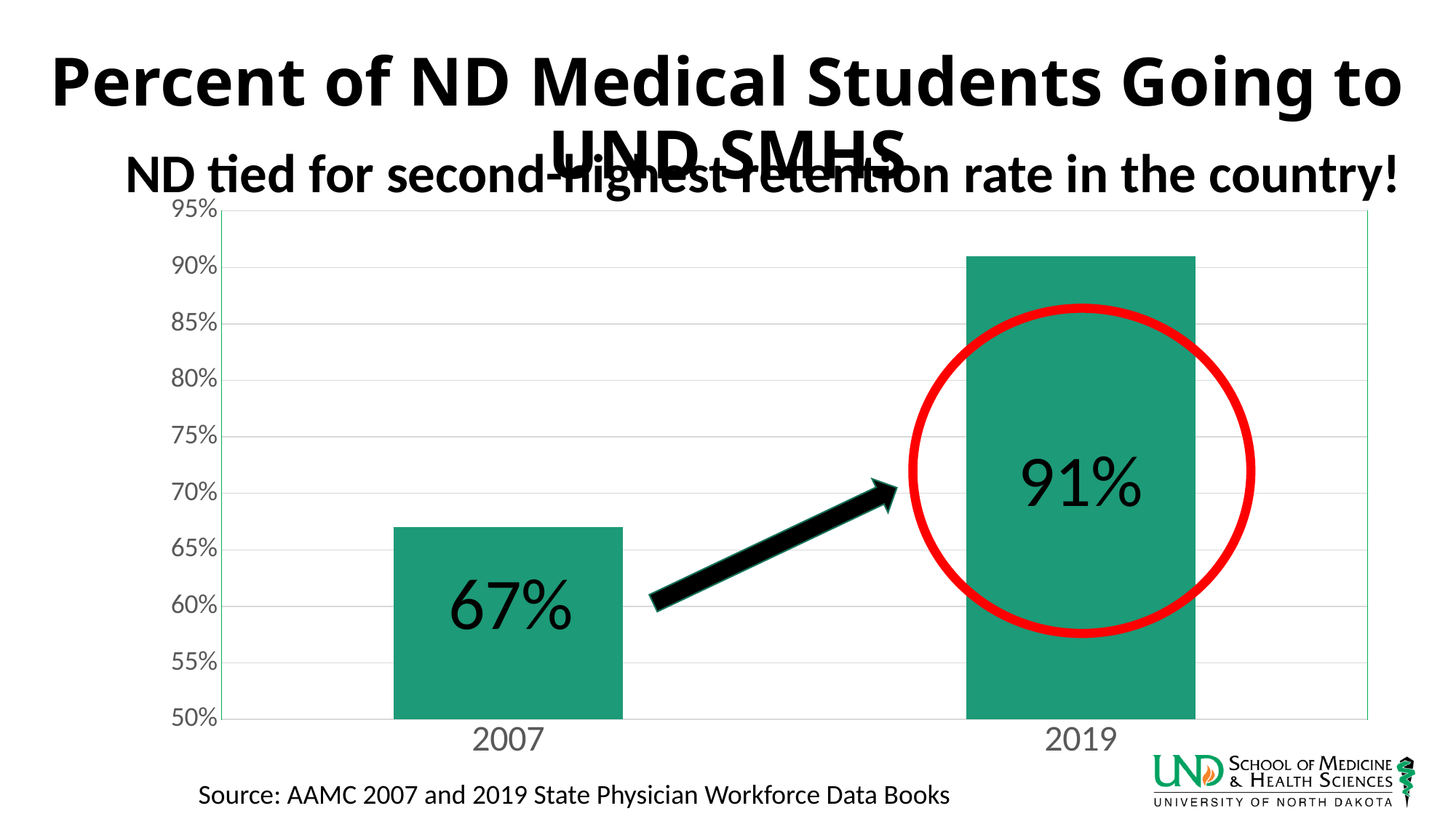
Is the value for 2019 greater or less than 90%? greater Do the values rise or fall from 2007 to 2019? rise What is the difference between the 2019 value and the 2007 value? 24% What is the value for 2007? 67% What is the value for 2019? 91% What colour are the bars in the chart? green Which year has the lower value? 2007 Is the value for 2007 greater or less than 70%? less How many bars are shown in the chart? 2 Which year has the higher value? 2019 What is the lowest value shown on the vertical axis? 50% What kind of chart is shown on the slide? bar chart